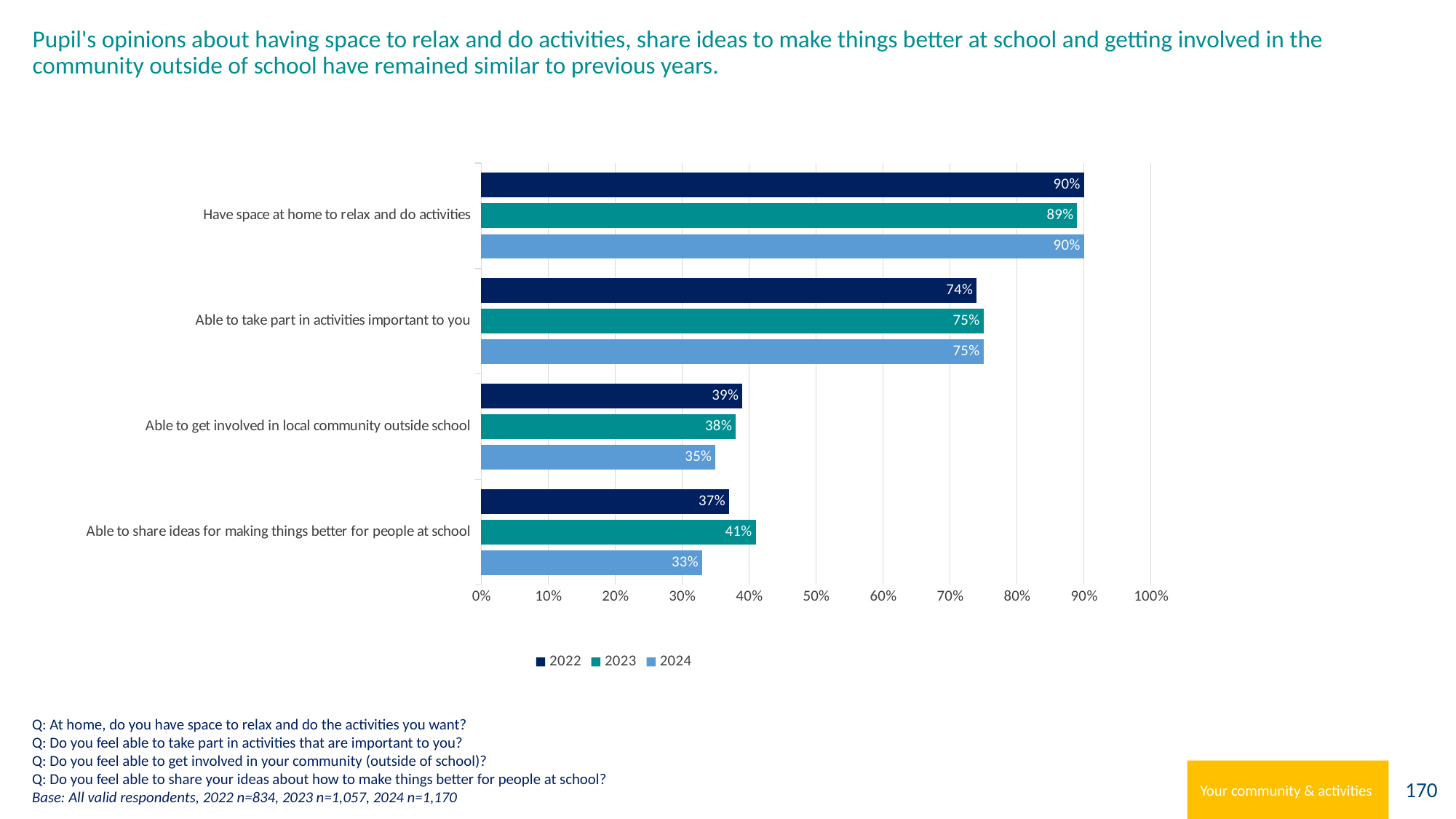
How many categories are shown on the chart? 4 What kind of chart is shown on the slide? Bar chart What is the difference between the 2023 and 2024 values for 'Able to share ideas for making things better for people at school'? 8% Which category has the highest 2022 value? Have space at home to relax and do activities What is the 2024 value for 'Have space at home to relax and do activities'? 90% For 'Able to get involved in local community outside school', is the 2022 value or the 2024 value larger? 2022 What is the 2023 value for 'Able to share ideas for making things better for people at school'? 41% Which years are listed in the legend? 2022, 2023, 2024 How many series does the legend list? 3 What is the 2022 value for 'Able to get involved in local community outside school'? 39% What is the difference between the 2022 and 2023 values for 'Able to take part in activities important to you'? 1% Which category has the lowest 2024 value? Able to share ideas for making things better for people at school